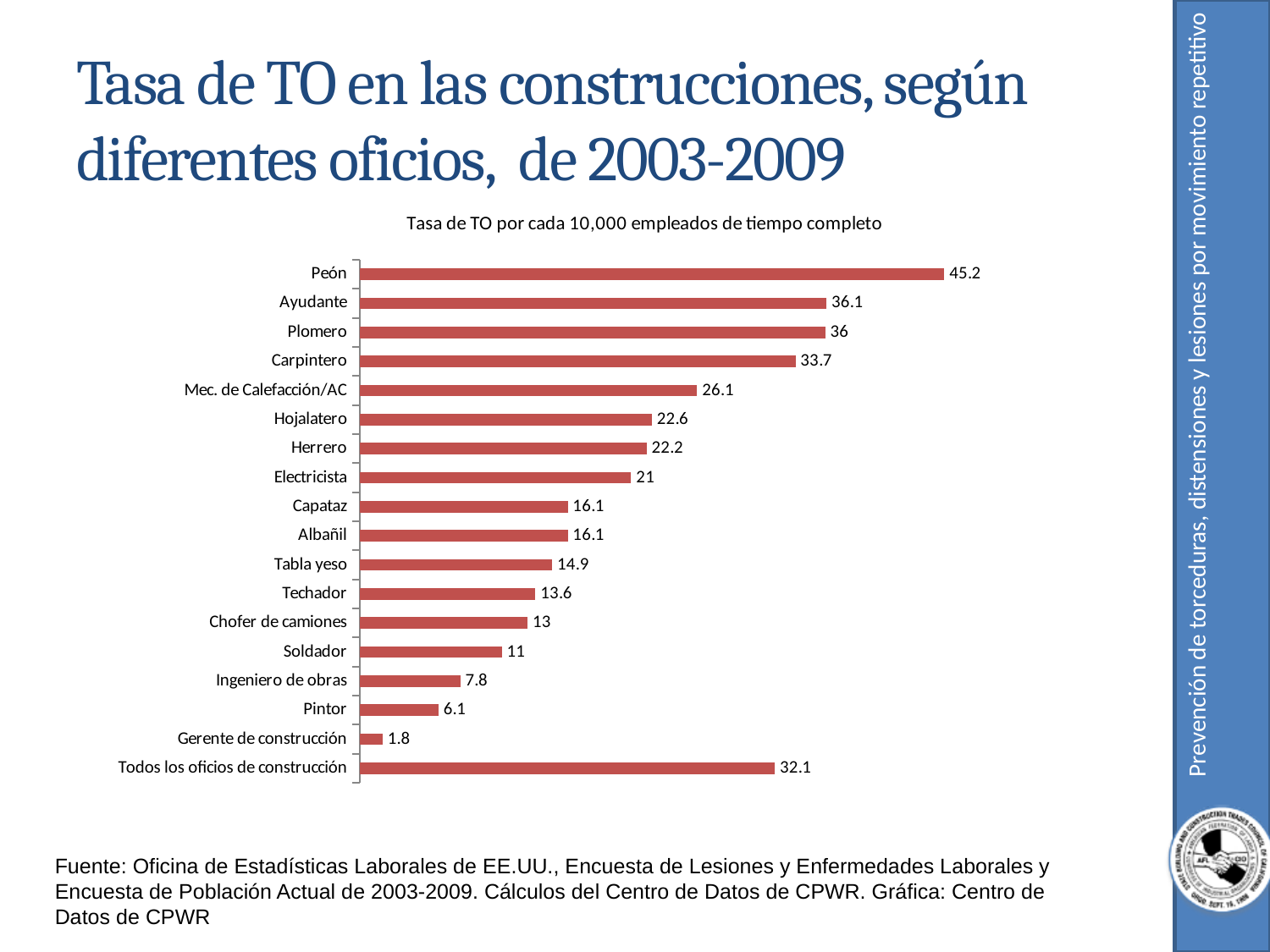
Which category has the lowest value? Gerente de construcción Which is larger, the value for Carpintero or the value for Mec. de Calefacción/AC? Carpintero What is the title of the chart? Tasa de TO por cada 10,000 empleados de tiempo completo How many categories are shown on the chart? 18 What is the difference between the values for Peón and Ayudante? 9.1 Which category has the highest value? Peón What kind of chart is shown on the slide? Bar chart What is the difference between the values for Soldador and Pintor? 4.9 What is the value for Peón? 45.2 What is the value for Chofer de camiones? 13 What is the value for Electricista? 21 What is the value for Todos los oficios de construcción? 32.1